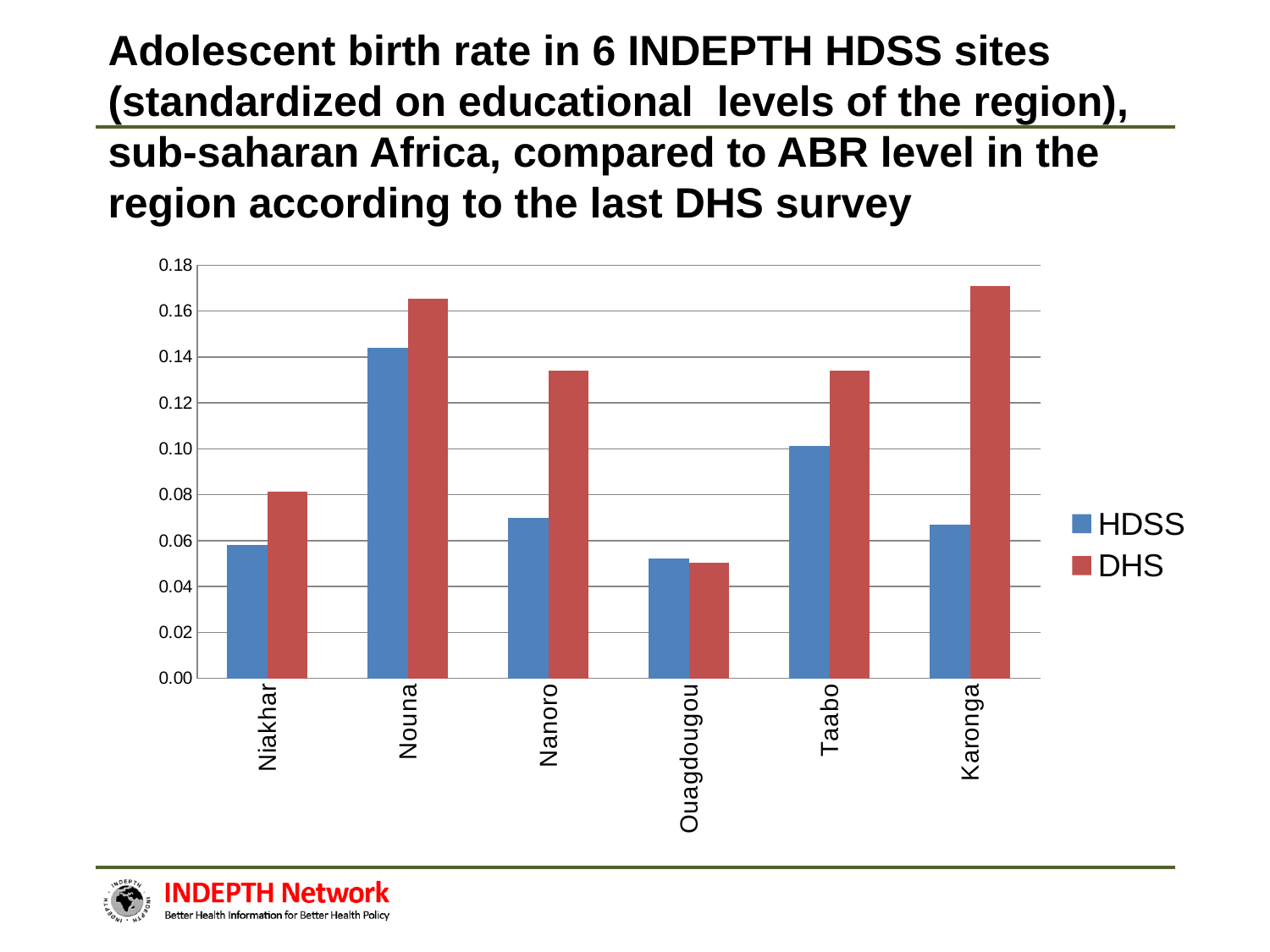
What kind of chart is shown on the slide? bar chart Is the HDSS value for Nouna greater or less than 0.12? greater Is the DHS value for Ouagdougou greater or less than 0.06? less Which is larger, the HDSS value for Nouna or the HDSS value for Taabo? Nouna Which site has the highest HDSS value? Nouna Is the HDSS value for Niakhar greater or less than 0.08? less What are the two series named in the chart's legend? HDSS and DHS How many series does the chart's legend list? 2 How many sites are shown on the x axis of the chart? 6 Which site has the highest DHS value? Karonga Which site has the lowest DHS value? Ouagdougou